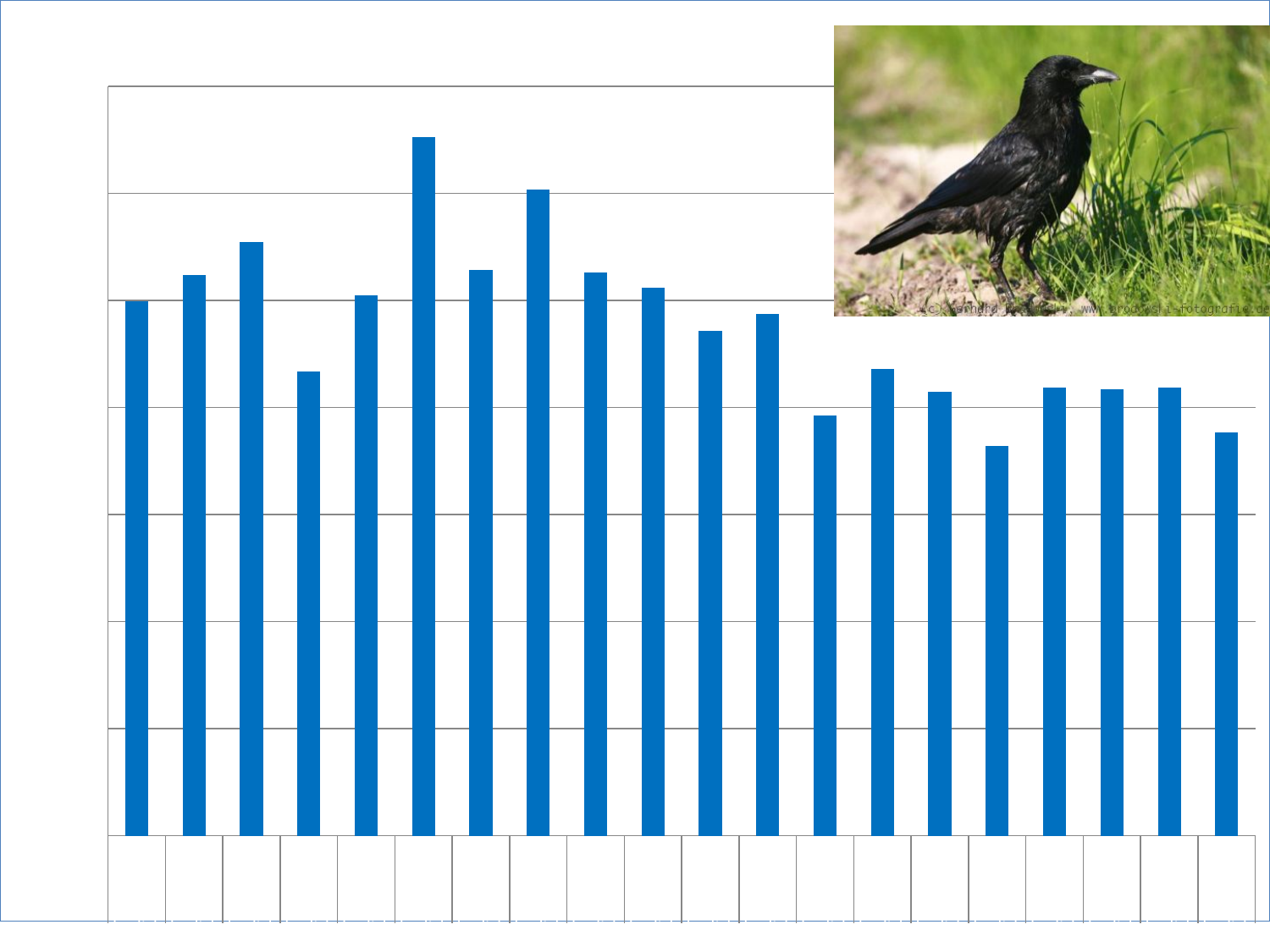
Is the 4th bar from the left taller or shorter than the 3rd bar from the left? shorter Is the last (rightmost) bar taller or shorter than the first (leftmost) bar? shorter Does the chart include a legend? No What colour are the bars in the chart? blue Do the bars in the right half of the chart generally sit higher or lower than those in the left half? lower Counting from the left, which bar is the shortest in the chart? the 16th bar Is the 6th bar from the left taller or shorter than the 8th bar from the left? taller Counting from the left, which bar is the tallest in the chart? the 6th bar What kind of chart is shown on the slide? bar chart How many bars are plotted in the chart? 20 How many data series are plotted in the chart? 1